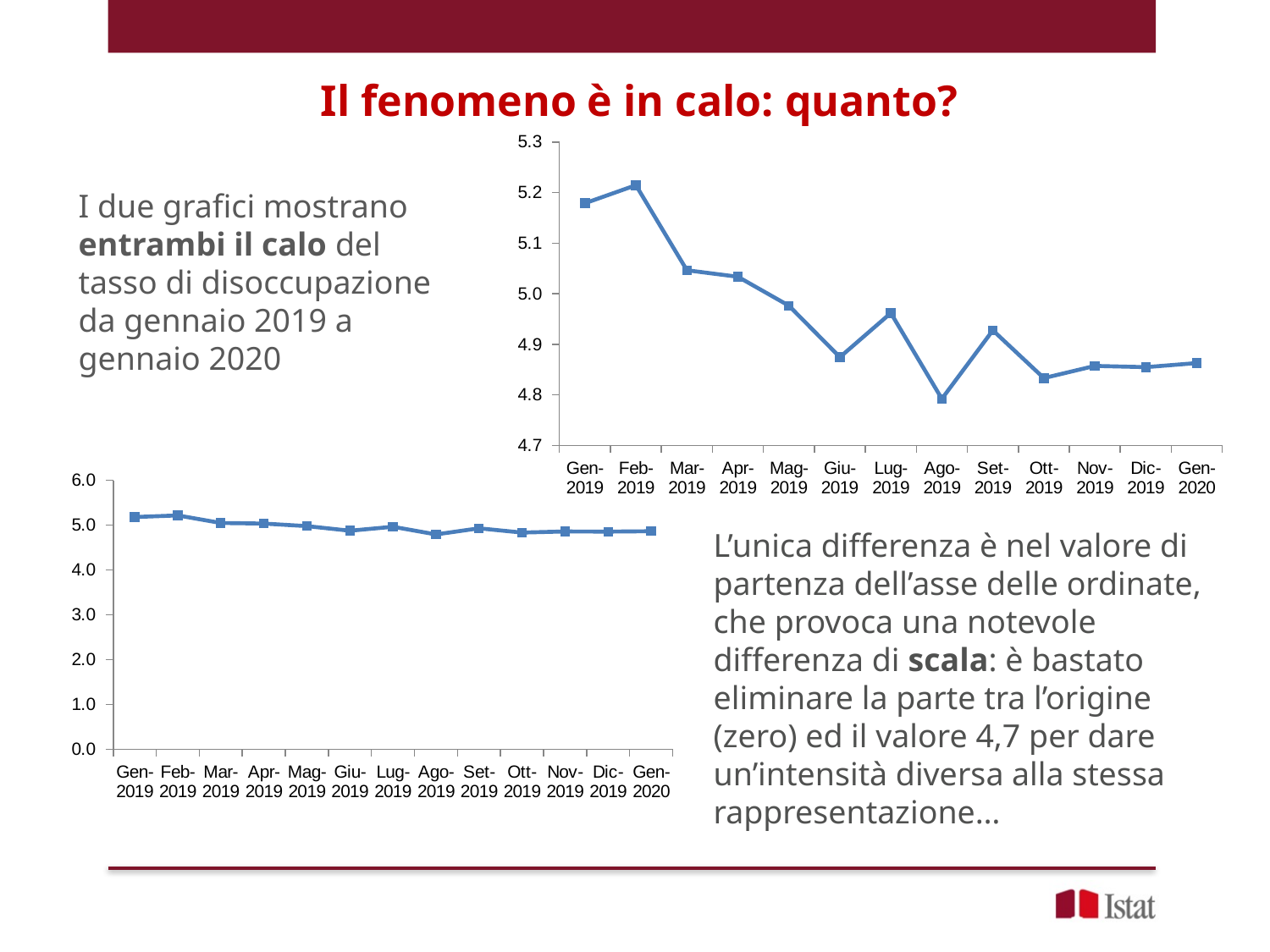
In the top-right chart, is the value for Mar-2019 greater or less than 5.0? greater In the bottom-left chart, do the values generally rise or fall from Gen-2019 to Gen-2020? fall In the top-right chart, which month has the lowest value? Ago-2019 In the top-right chart, is the value for Gen-2019 greater or less than 5.1? greater In the top-right chart, is the value for Giu-2019 greater or less than 4.9? less At what value does the vertical axis of the bottom-left chart start? 0.0 At what value does the vertical axis of the top-right chart start? 4.7 In the top-right chart, which is larger, the value for Giu-2019 or the value for Lug-2019? Lug-2019 What kind of chart is the top-right chart on the slide? line chart How many data points are plotted in the bottom-left chart? 13 In the top-right chart, which month has the highest value? Feb-2019